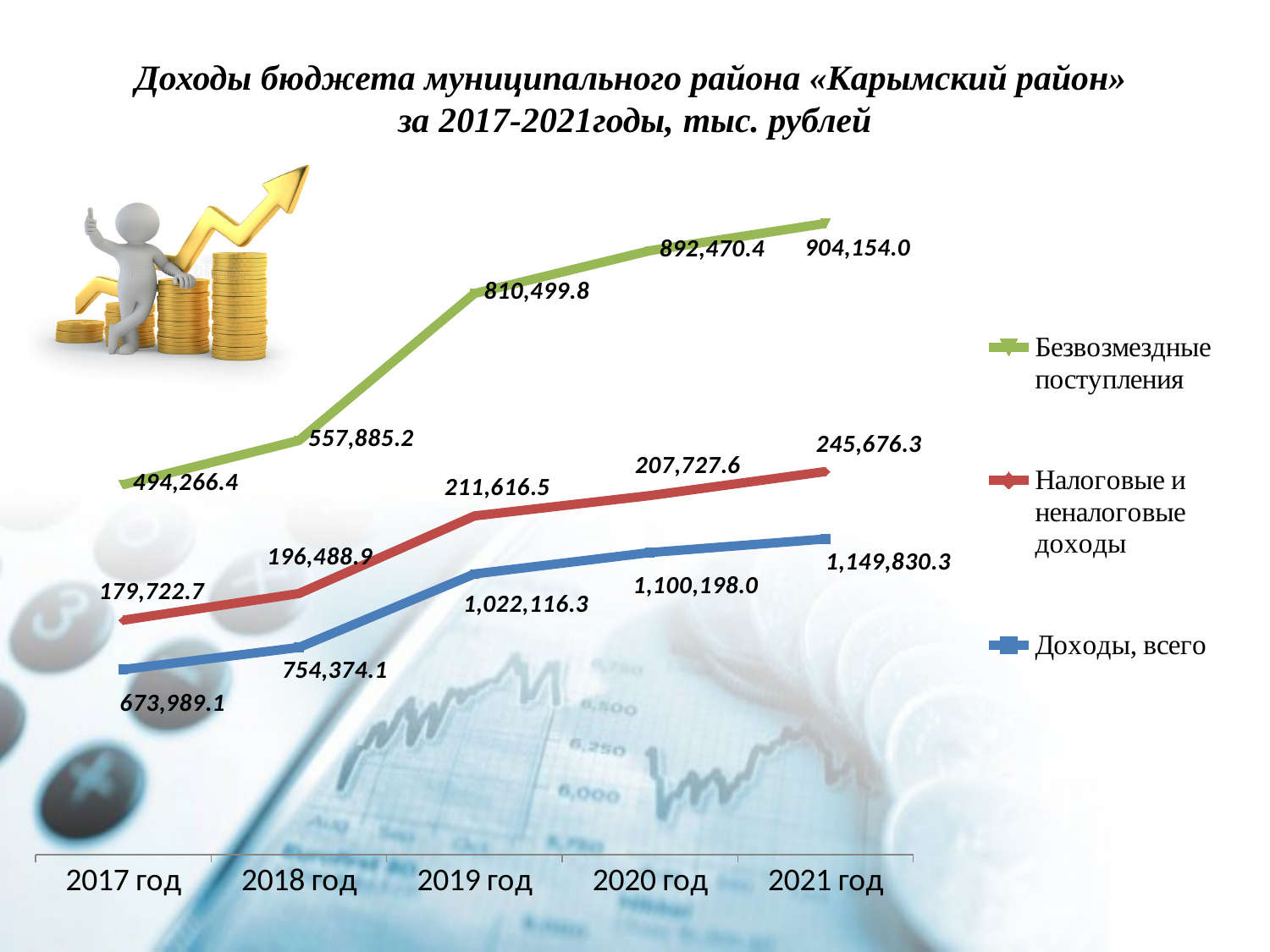
What is the difference between the Безвозмездные поступления values for 2021 год and 2017 год? 409,887.6 What is the value for Налоговые и неналоговые доходы in 2017 год? 179,722.7 How many series does the legend list? 3 Which is larger in 2020 год: Безвозмездные поступления or Налоговые и неналоговые доходы? Безвозмездные поступления What is the difference between the Налоговые и неналоговые доходы values for 2021 год and 2017 год? 65,953.6 How many years are shown on the x axis? 5 What is the value for Безвозмездные поступления in 2019 год? 810,499.8 What kind of chart is shown on the slide? Line chart What is the value for Доходы, всего in 2021 год? 1,149,830.3 In which year is the value for Безвозмездные поступления highest? 2021 год What is the value for Доходы, всего in 2018 год? 754,374.1 In which year is the value for Налоговые и неналоговые доходы lowest? 2017 год